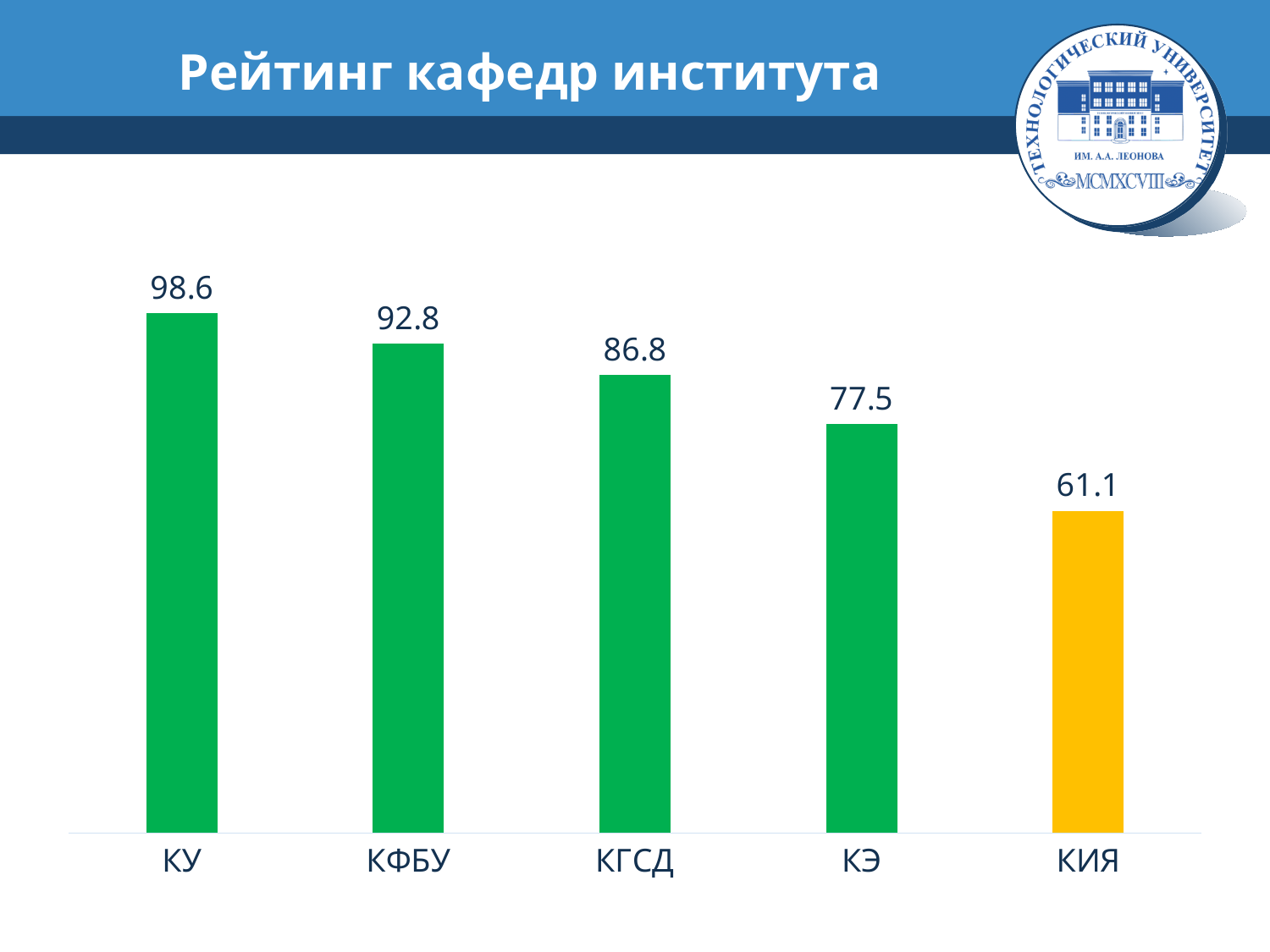
What is the value for КФБУ? 92.8 Which category has the lowest value? КИЯ What is the value for КГСД? 86.8 How many categories are shown in the chart? 5 What is the value for КЭ? 77.5 Do the values rise or fall from left to right along the x axis? Fall What kind of chart is shown on the slide? Bar chart Which category has the highest value? КУ What is the value for КУ? 98.6 What is the difference between the values for КУ and КИЯ? 37.5 What is the value for КИЯ? 61.1 Which is larger, the value for КГСД or the value for КЭ? КГСД